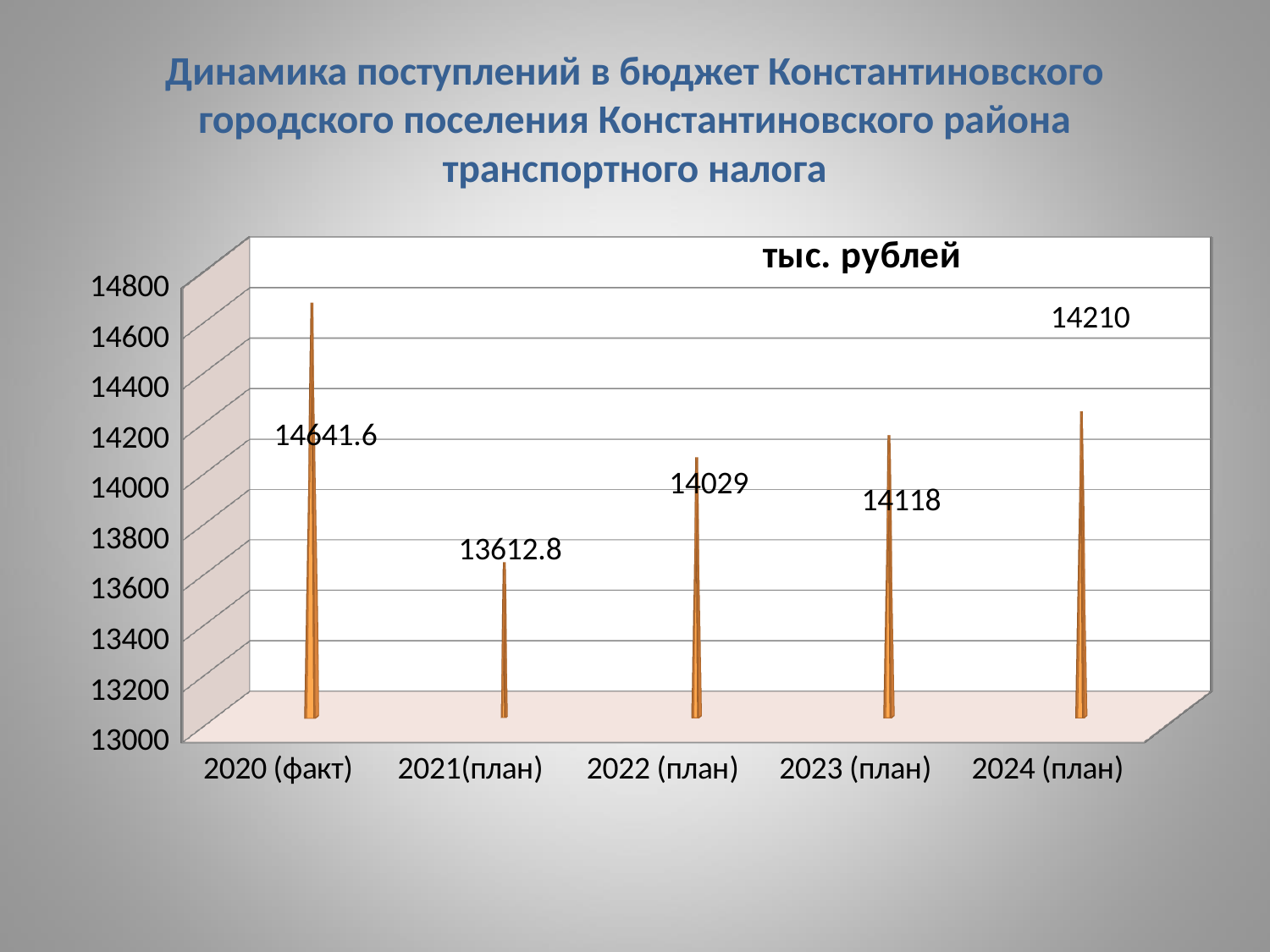
What is the value for 2021(план)? 13612.8 What is the value for 2024 (план)? 14210 Do the values rise or fall from 2021(план) to 2024 (план)? rise What is the difference between the values for 2020 (факт) and 2021(план)? 1028.8 How many categories are shown on the x axis? 5 What is the value for 2023 (план)? 14118 What is the value for 2020 (факт)? 14641.6 Which is larger, the value for 2022 (план) or the value for 2023 (план)? 2023 (план) Which category has the lowest value? 2021(план) Which category has the highest value? 2020 (факт) What is the difference between the values for 2024 (план) and 2023 (план)? 92 What unit of measurement is shown on the chart? тыс. рублей